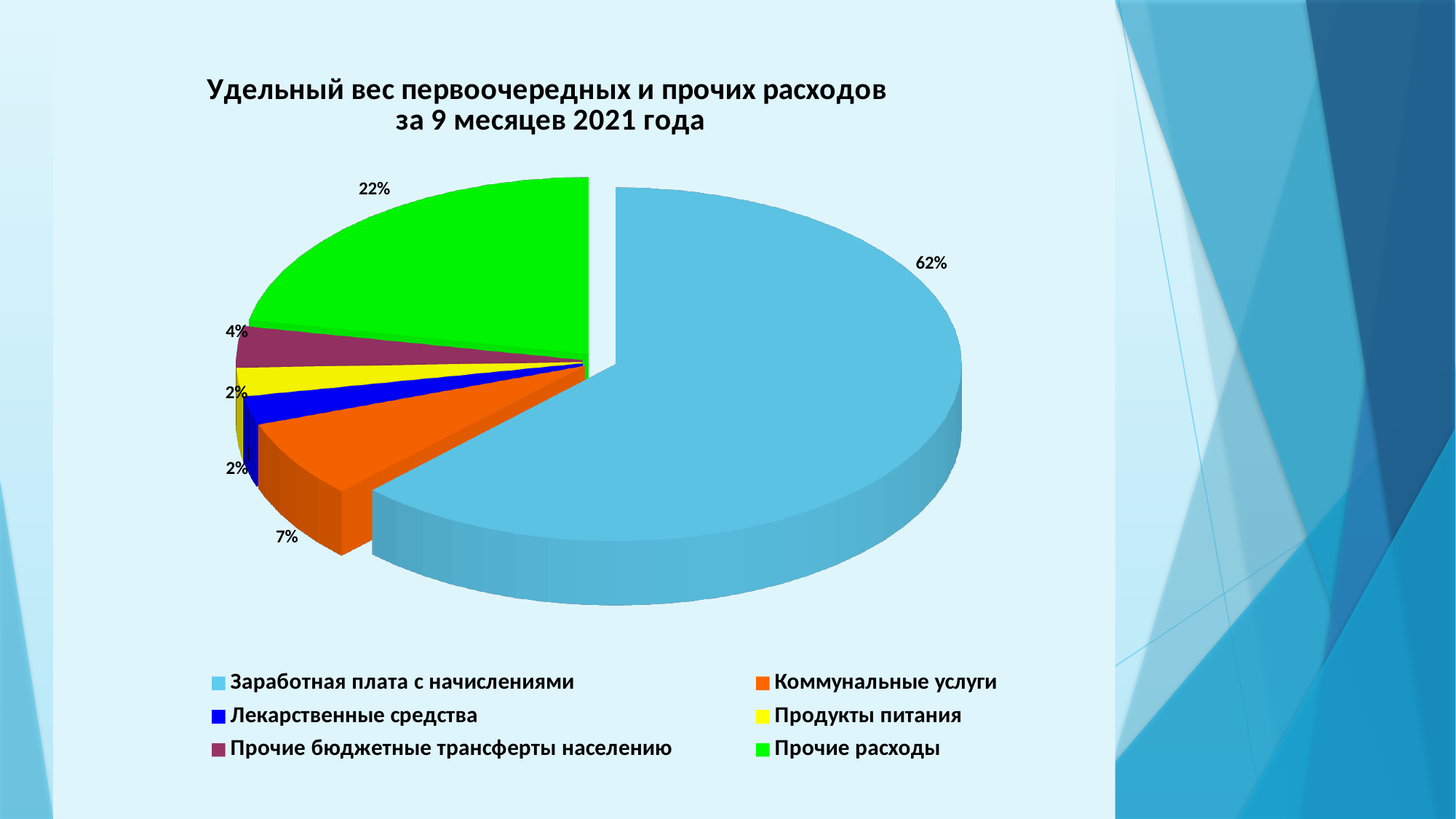
What colour is the slice for Прочие расходы? Green What share of the pie does Заработная плата с начислениями take? 62% What is the value shown for Лекарственные средства? 2% What is the value shown for Прочие расходы? 22% What is the value shown for Прочие бюджетные трансферты населению? 4% What is the difference between the shares of Заработная плата с начислениями and Прочие расходы? 40% What kind of chart is shown on the slide? Pie chart Which is larger, the share of Коммунальные услуги or the share of Прочие бюджетные трансферты населению? Коммунальные услуги What is the title of the chart? Удельный вес первоочередных и прочих расходов за 9 месяцев 2021 года Which category has the largest share of the pie? Заработная плата с начислениями How many categories are shown in the pie chart? 6 What is the value shown for Коммунальные услуги? 7%